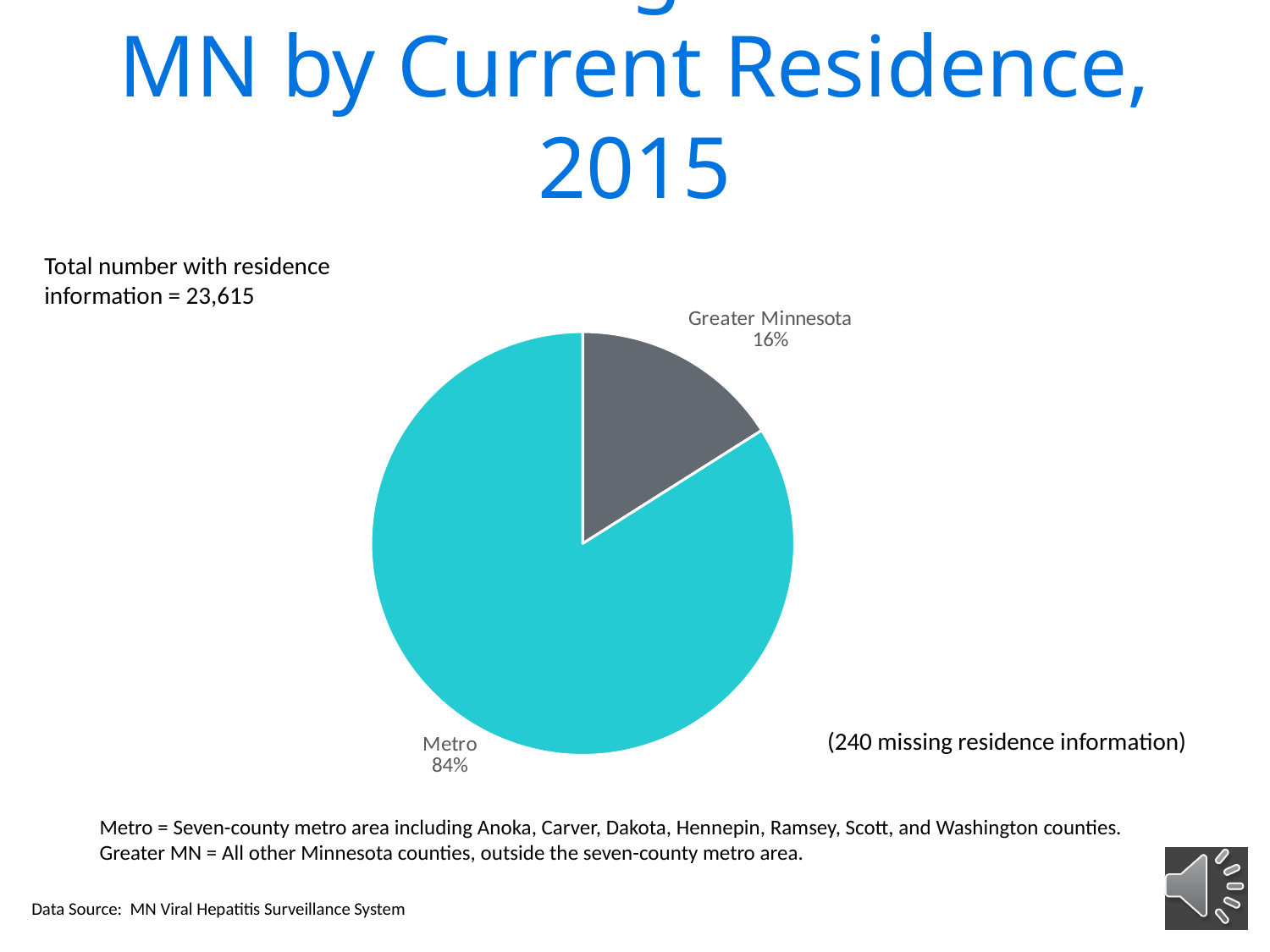
Which slice of the pie is the smallest? Greater Minnesota What is the total number with residence information stated on the slide? 23,615 What colour is the Metro slice of the pie? teal Which is larger, the Metro slice or the Greater Minnesota slice? Metro What colour is the Greater Minnesota slice of the pie? grey How many slices does the pie chart have? 2 What share of the pie does Greater Minnesota represent? 16% What is the difference in percentage points between the Metro and Greater Minnesota slices? 68 What kind of chart is shown on the slide? pie chart How many records are noted as missing residence information? 240 What share of the pie does Metro represent? 84% Which slice of the pie is the largest? Metro